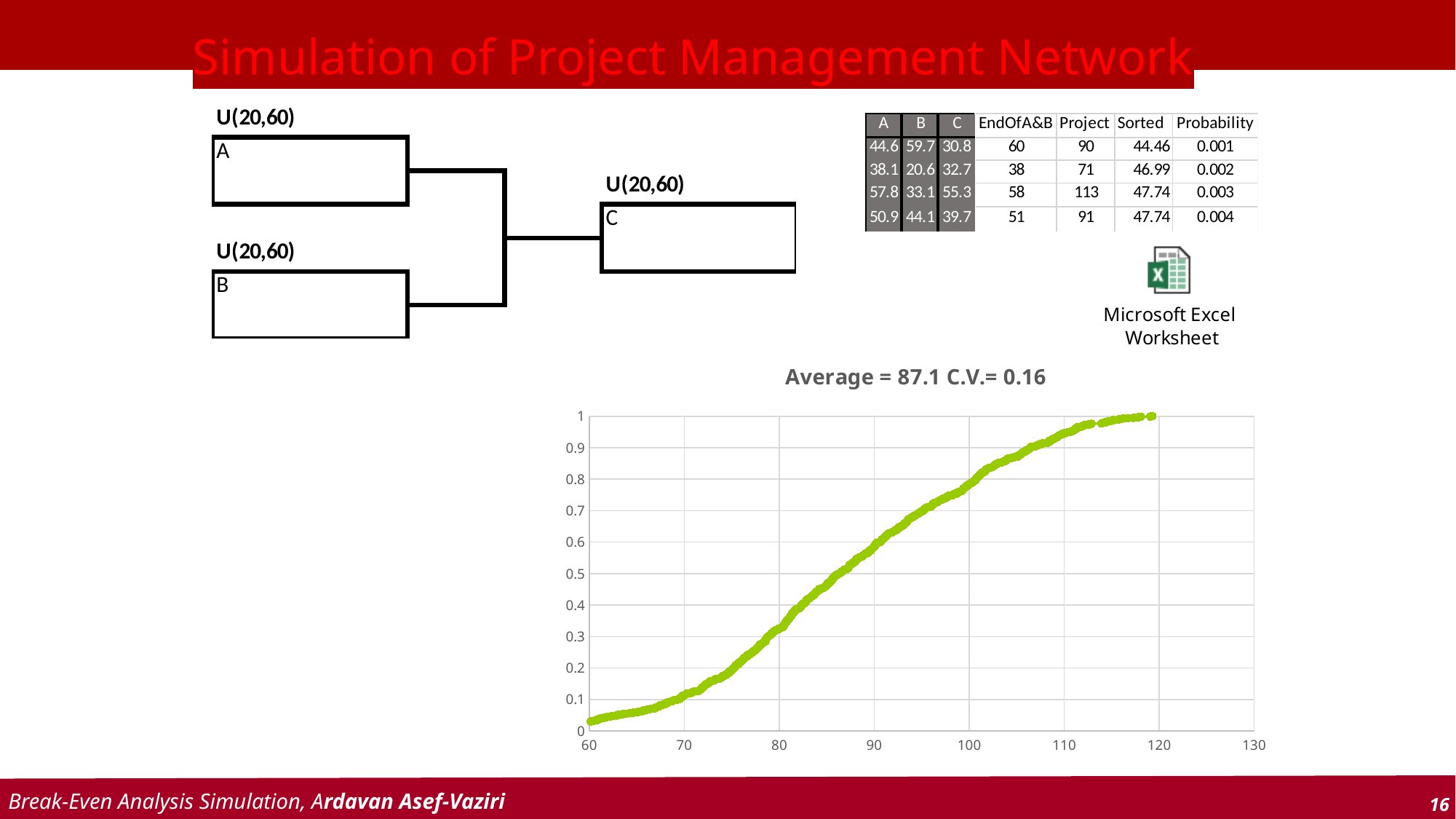
Is the plotted value at x = 80 greater or less than 0.5? less Is the plotted value at x = 100 greater or less than 0.5? greater Is the plotted value at x = 85 greater or less than 0.6? less What kind of chart is shown on the slide? scatter chart What is the highest tick value shown on the x axis of the chart? 130 Do the plotted values rise or fall as the x-axis value increases from 60 to 120? rise What is the title of the chart on the slide? Average = 87.1 C.V.= 0.16